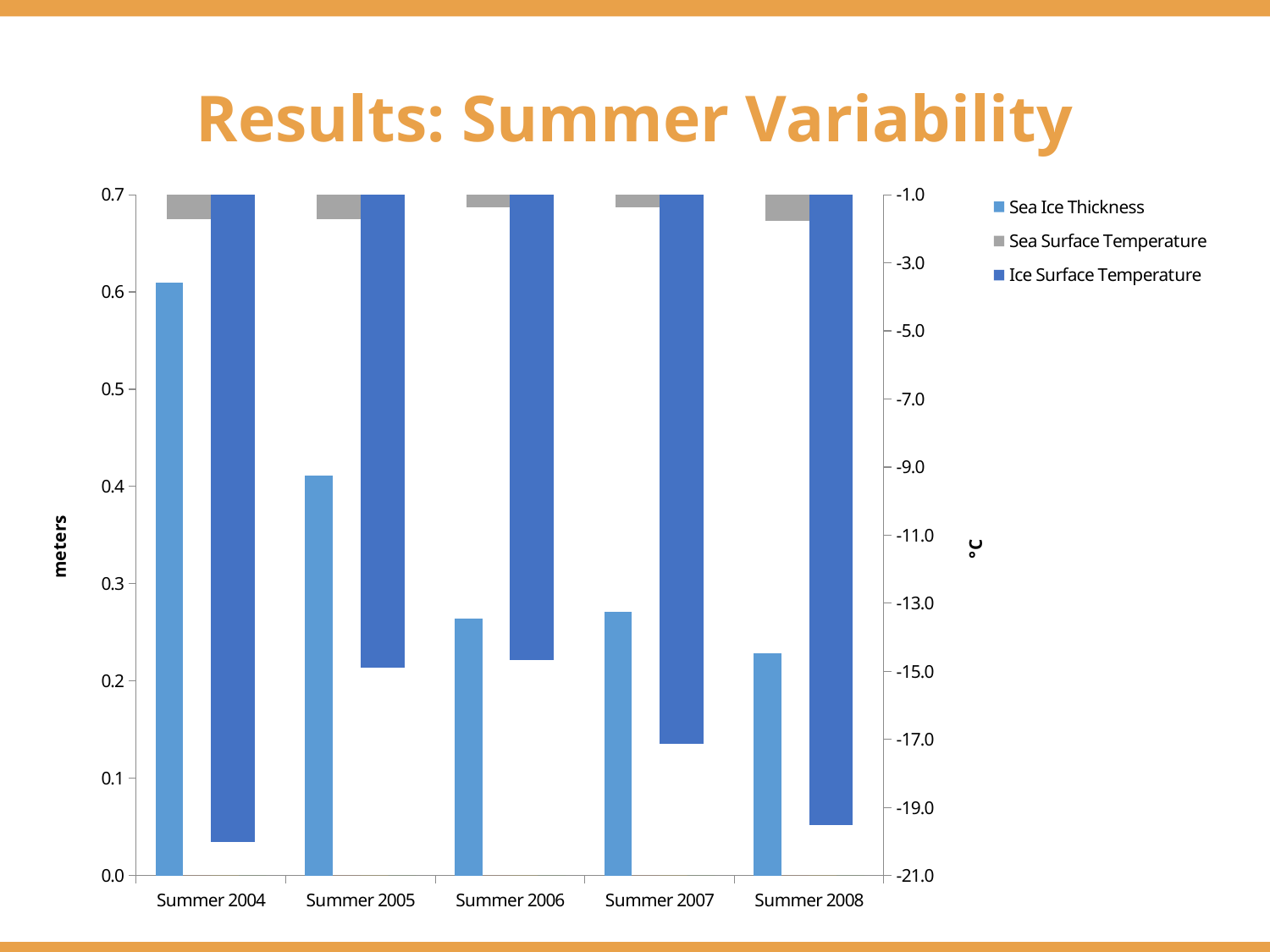
How many series does the legend list? 3 Is the Sea Ice Thickness for Summer 2004 greater or less than 0.5 meters? greater Is the Ice Surface Temperature for Summer 2007 greater or less than -15.0 °C? less Which summer has the lowest Sea Ice Thickness? Summer 2008 Which summer has the highest Sea Ice Thickness? Summer 2004 What is the label of the left vertical axis? meters Is the Sea Ice Thickness for Summer 2005 greater or less than 0.5 meters? less Which series is shown in gray in the legend? Sea Surface Temperature What kind of chart is shown on the slide? bar chart Which summer has the lowest (most negative) Ice Surface Temperature? Summer 2004 Which is larger, the Sea Ice Thickness for Summer 2004 or for Summer 2005? Summer 2004 How many summer categories are shown on the x axis? 5